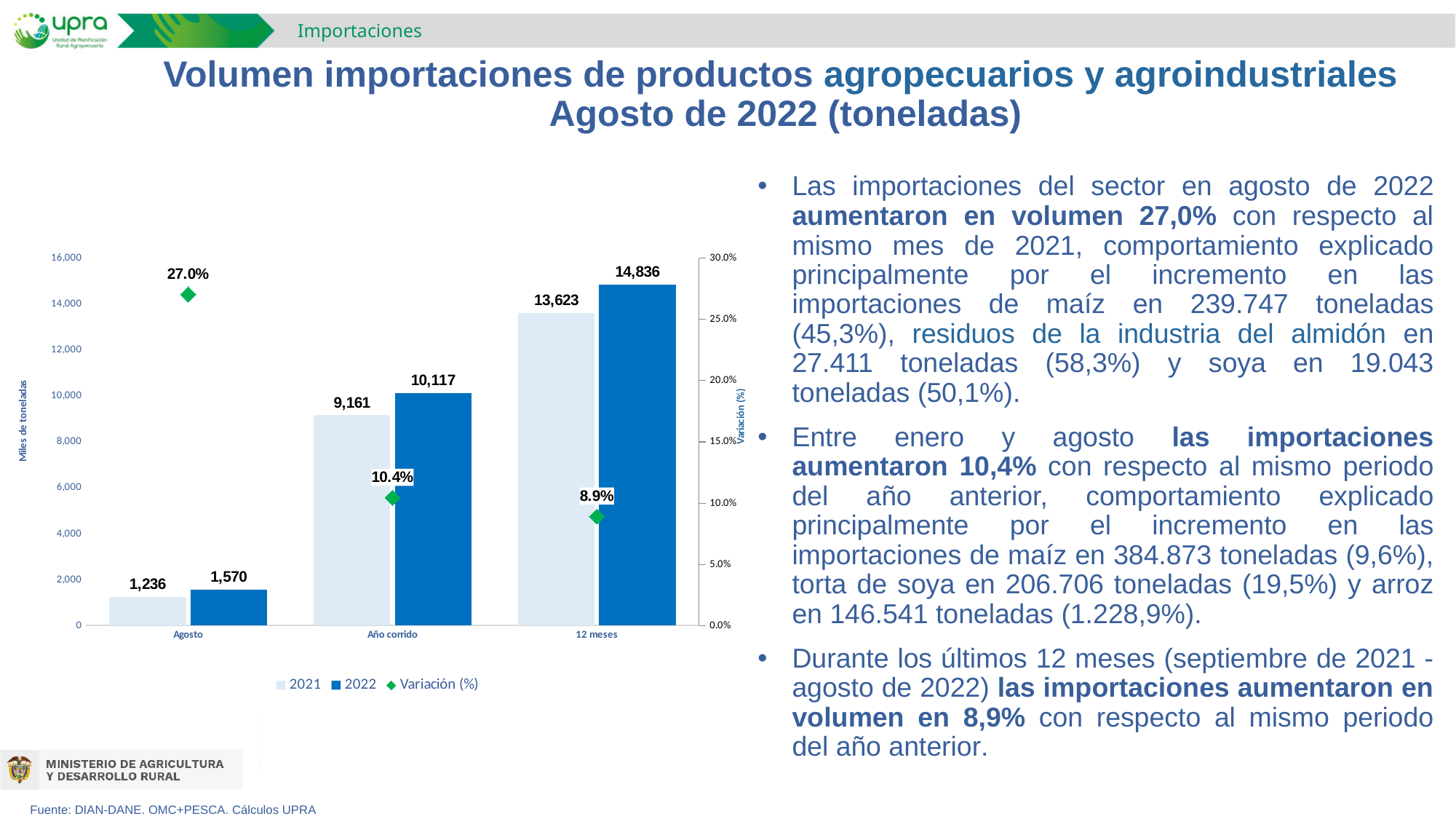
What kind of chart is this? Bar chart with a line/marker series What is the Variación (%) value for 12 meses? 8.9% What is the 2022 value for Agosto? 1,570 Which is larger for Año corrido, the 2021 value or the 2022 value? 2022 How many series does the legend list? 3 What is the 2021 value for Año corrido? 9,161 Which category has the highest 2022 value? 12 meses How many categories are shown on the x axis? 3 What is the label of the left vertical axis? Miles de toneladas Which category has the lowest 2021 value? Agosto What is the difference between the 2022 and 2021 values for 12 meses? 1,213 Which category has the highest Variación (%)? Agosto